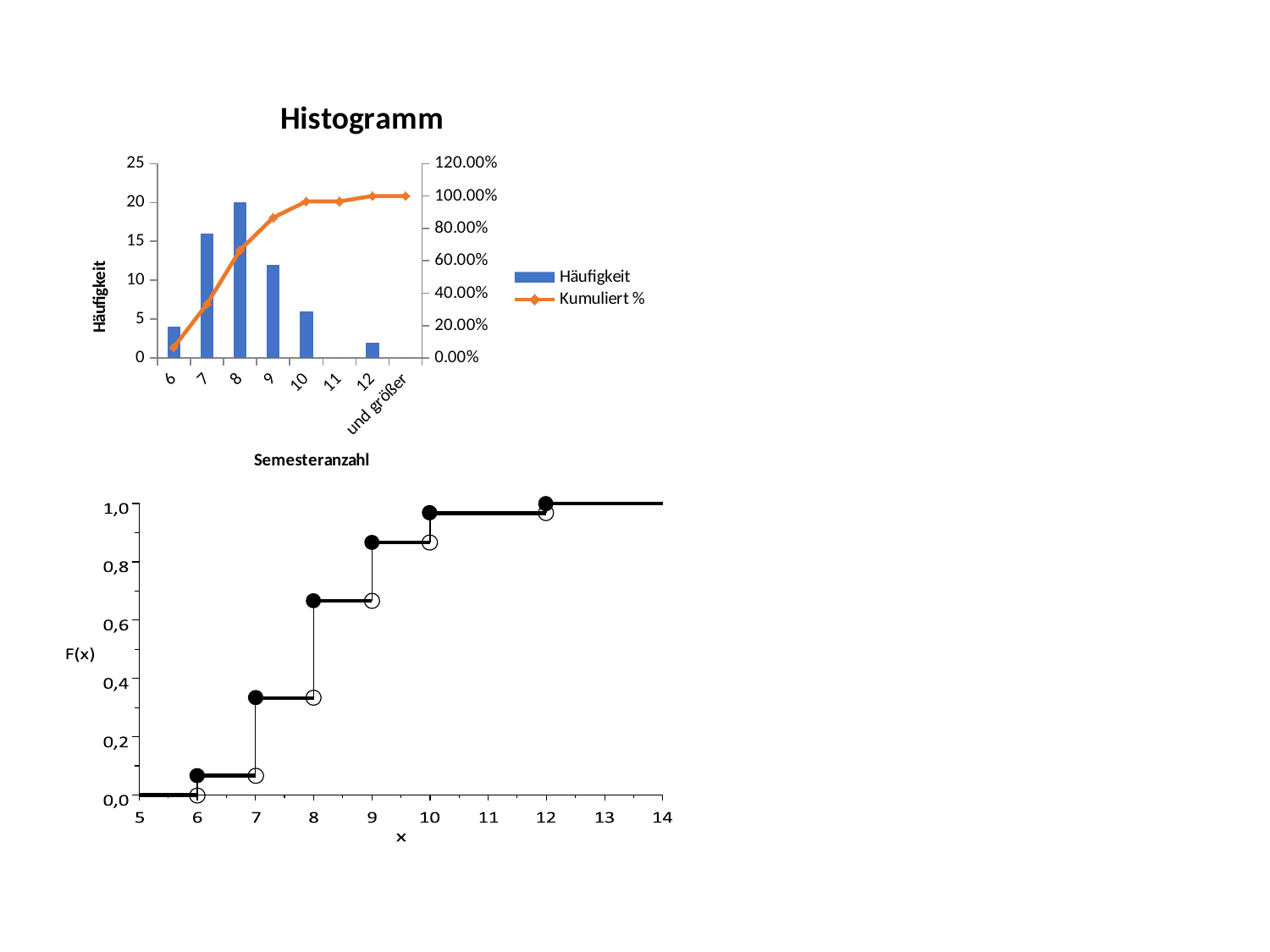
What is the title of the x axis of the Histogramm chart? Semesteranzahl In the Histogramm chart, is the Häufigkeit for Semesteranzahl 12 greater or less than 5? less In the Histogramm chart, what is the Häufigkeit value for Semesteranzahl 8? 20 In the lower F(x) chart, is the value of F(x) at x = 8 greater or less than 0,6? greater In the lower F(x) chart, what is the value of F(x) at x = 12? 1,0 In the Histogramm chart, which has the larger Häufigkeit, Semesteranzahl 7 or Semesteranzahl 10? 7 How many series does the legend of the Histogramm chart list? 2 In the Histogramm chart, is the Häufigkeit for Semesteranzahl 7 greater or less than 10? greater How many categories are shown on the x axis of the Histogramm chart? 8 In the lower F(x) chart, do the values of F(x) rise or fall as x increases? rise In the Histogramm chart, which Semesteranzahl category has the highest Häufigkeit? 8